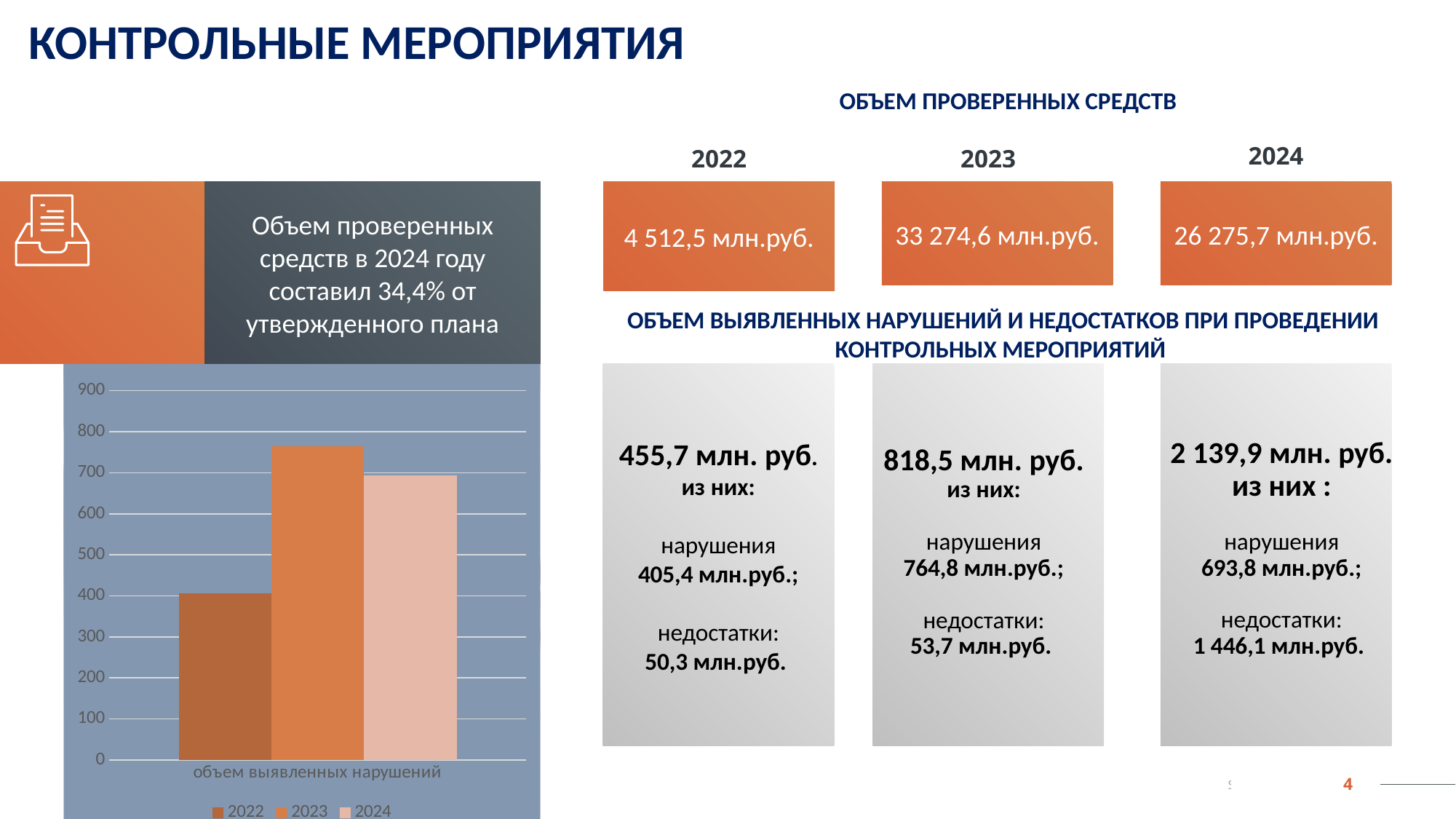
What kind of chart is shown on the left of the slide? bar chart How many series does the legend of the bar chart list? 3 What is the category label on the x axis of the bar chart? объем выявленных нарушений In the bar chart, which bar is taller: 2023 or 2024? 2023 Is the value for 2023 in the bar chart greater or less than 700? greater In the bar chart, which bar is taller: 2022 or 2024? 2024 Which year has the shortest bar in the bar chart? 2022 Is the value for 2024 in the bar chart greater or less than 600? greater Is the value for 2022 in the bar chart greater or less than 500? less Which year has the tallest bar in the bar chart? 2023 How many categories are shown on the x axis of the bar chart? 1 What are the legend entries of the bar chart? 2022, 2023, 2024